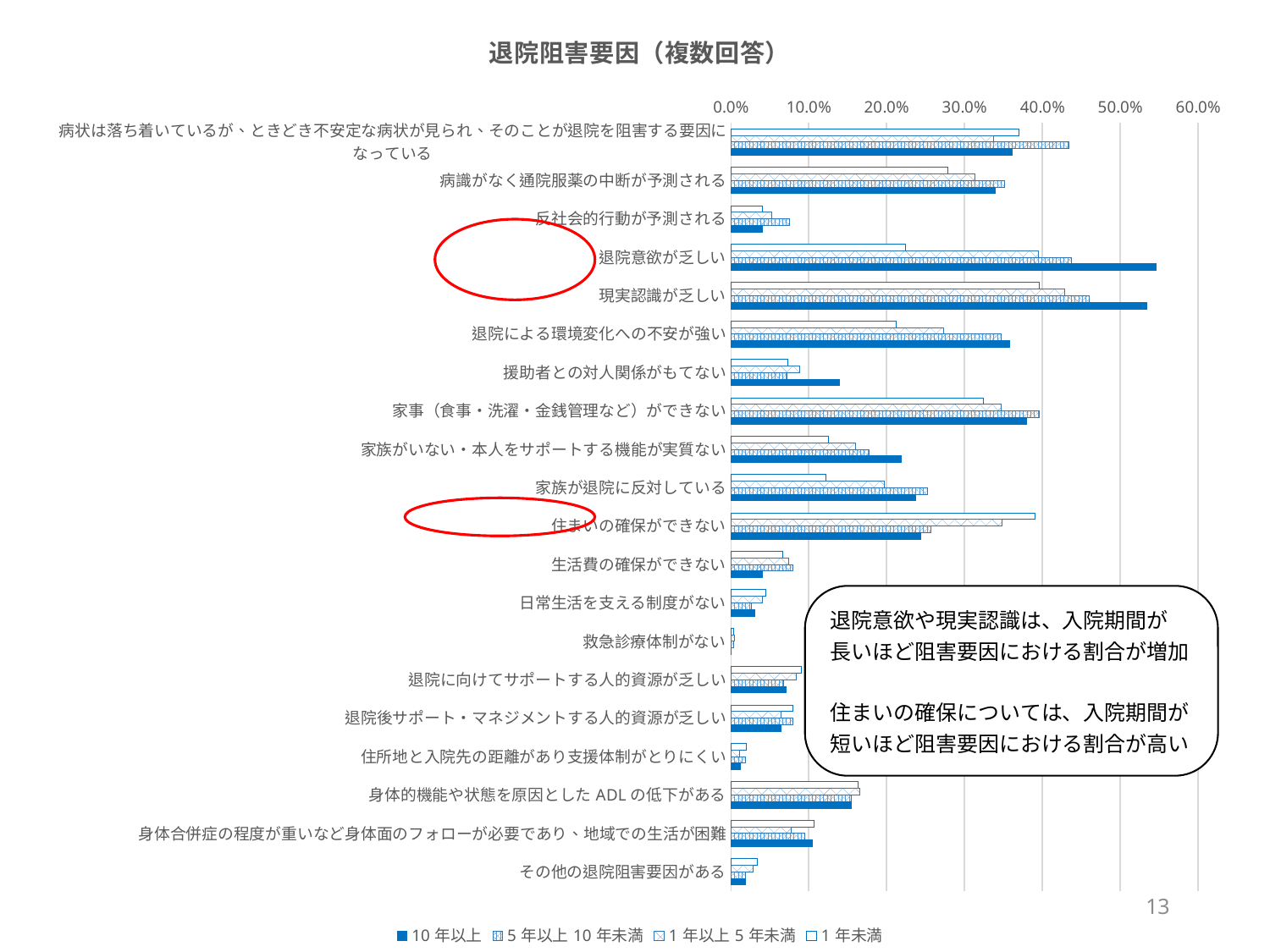
For 退院意欲が乏しい, which series has the larger value: 10年以上 or 1年未満? 10年以上 What is the title of the chart? 退院阻害要因（複数回答） Is the value for 退院意欲が乏しい in the 10年以上 series greater or less than 50.0%? greater How many series does the legend list? 4 Is the value for 現実認識が乏しい in the 10年以上 series greater or less than 50.0%? greater Is the value for 住まいの確保ができない in the 1年未満 series greater or less than 30.0%? greater Which category has the smallest values across all series? 救急診療体制がない What kind of chart is shown on the slide? bar chart How many categories are plotted on the chart? 20 For 住まいの確保ができない, which series has the larger value: 1年未満 or 10年以上? 1年未満